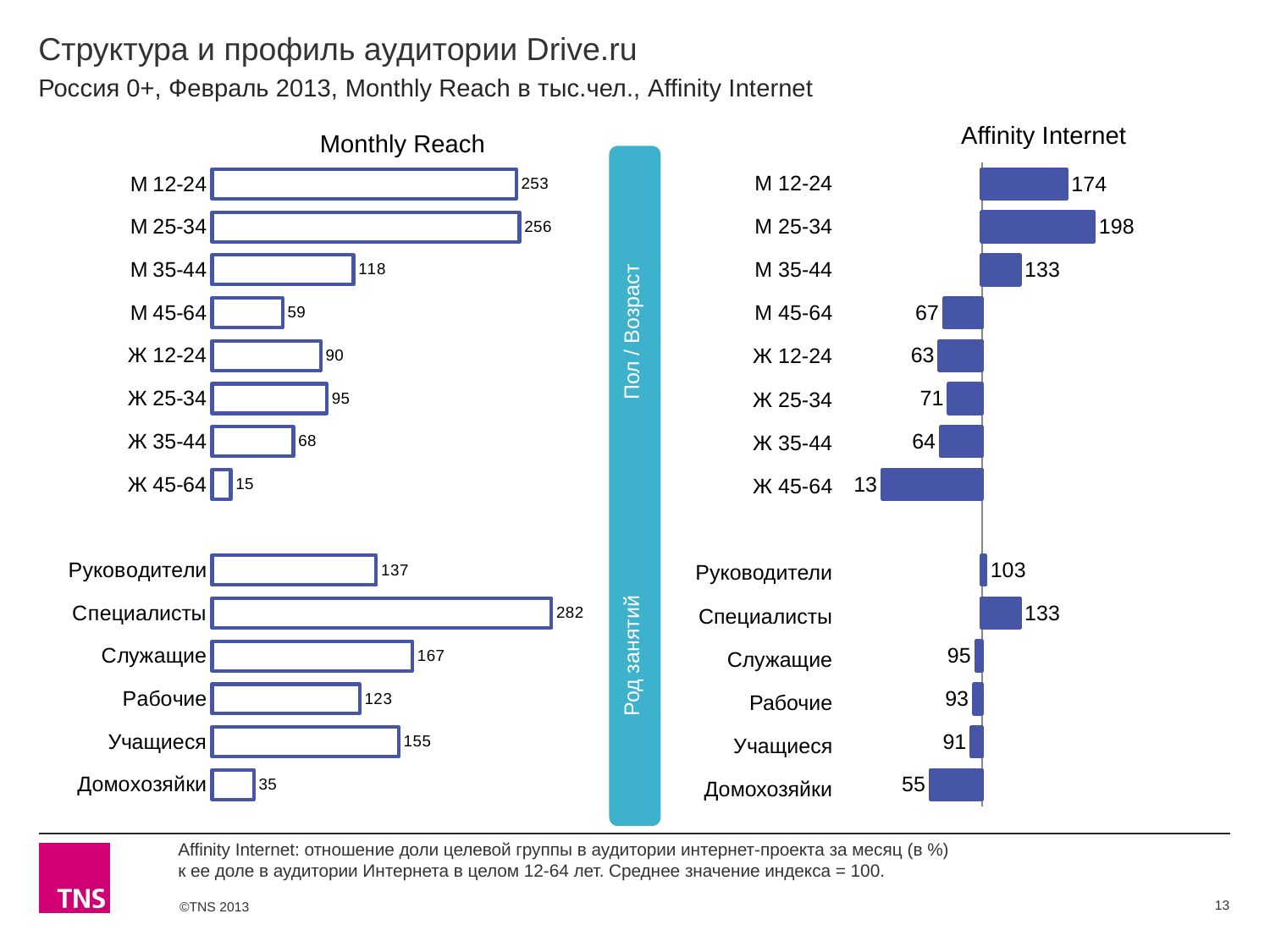
In the Monthly Reach chart, which category has the highest value? Специалисты In the Monthly Reach chart, which category has the lowest value? Ж 45-64 In the Affinity Internet chart, what is the value for Ж 45-64? 13 In the Monthly Reach chart, what is the difference between the values for Специалисты and Руководители? 145 How many categories are plotted in the Monthly Reach chart? 14 In the Affinity Internet chart, which is larger, the value for Руководители or the value for Служащие? Руководители In the Affinity Internet chart, what is the difference between the values for М 12-24 and М 45-64? 107 In the Monthly Reach chart, what is the value for Домохозяйки? 35 In the Monthly Reach chart, what is the value for М 25-34? 256 What kind of chart is the Affinity Internet chart? Bar chart In the Affinity Internet chart, which category has the highest value? М 25-34 In the Affinity Internet chart, what is the value for Специалисты? 133